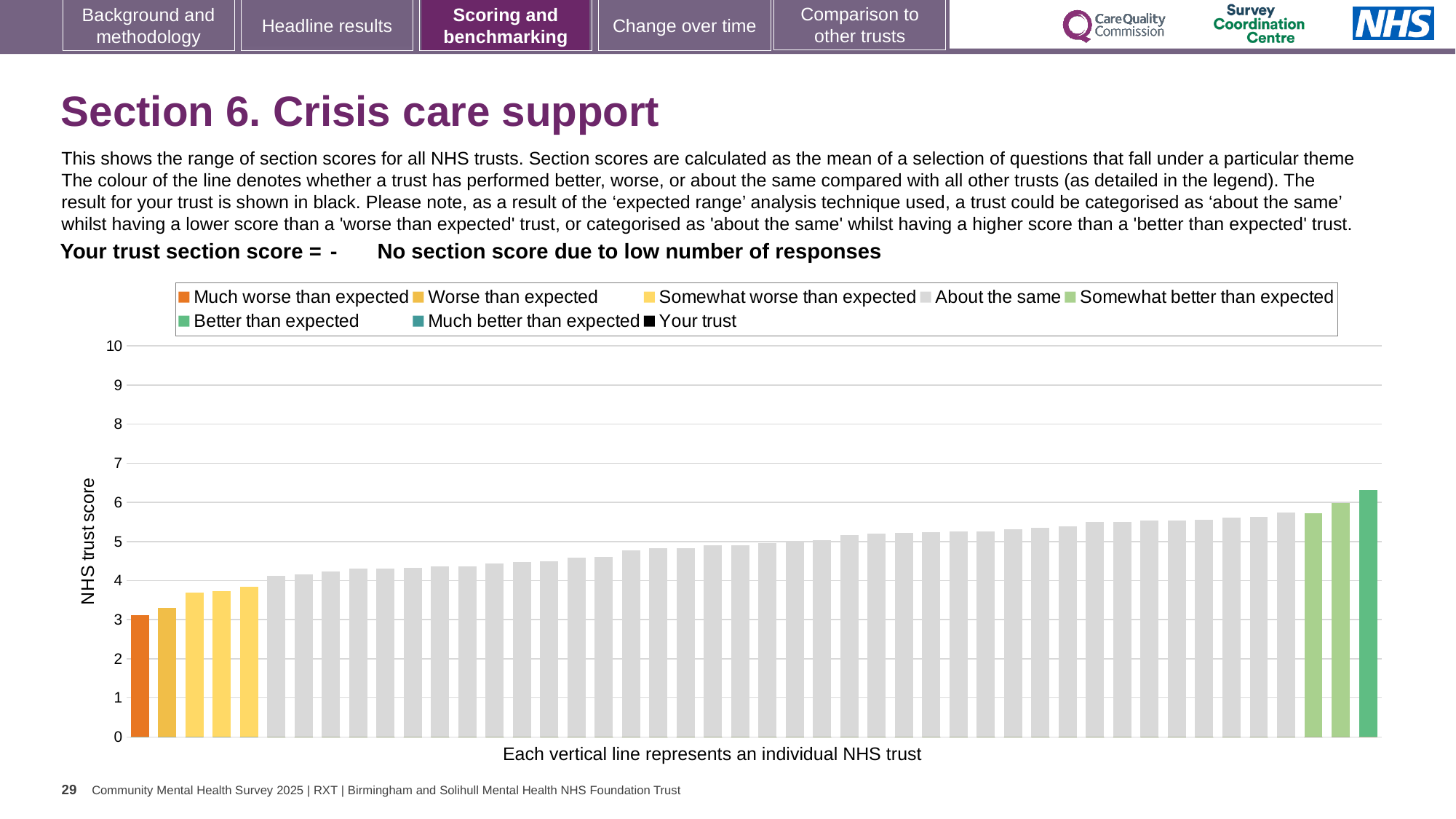
Is the value of the highest bar (the 'Better than expected' trust) greater or less than 7? less How many entries does the chart legend list? 8 What kind of chart is shown on the slide? Bar chart Which legend category does the lowest bar on the chart belong to? Much worse than expected What is the label on the vertical axis of the chart? NHS trust score How many bars are coloured as 'Somewhat better than expected'? 2 How many bars are coloured as 'Somewhat worse than expected'? 3 Is the value of the lowest bar (the 'Much worse than expected' trust) greater or less than 3? greater Is the value of the lowest bar (the 'Much worse than expected' trust) greater or less than 4? less Do the bar values rise or fall from left to right along the x axis? Rise Which legend category does the highest bar on the chart belong to? Better than expected